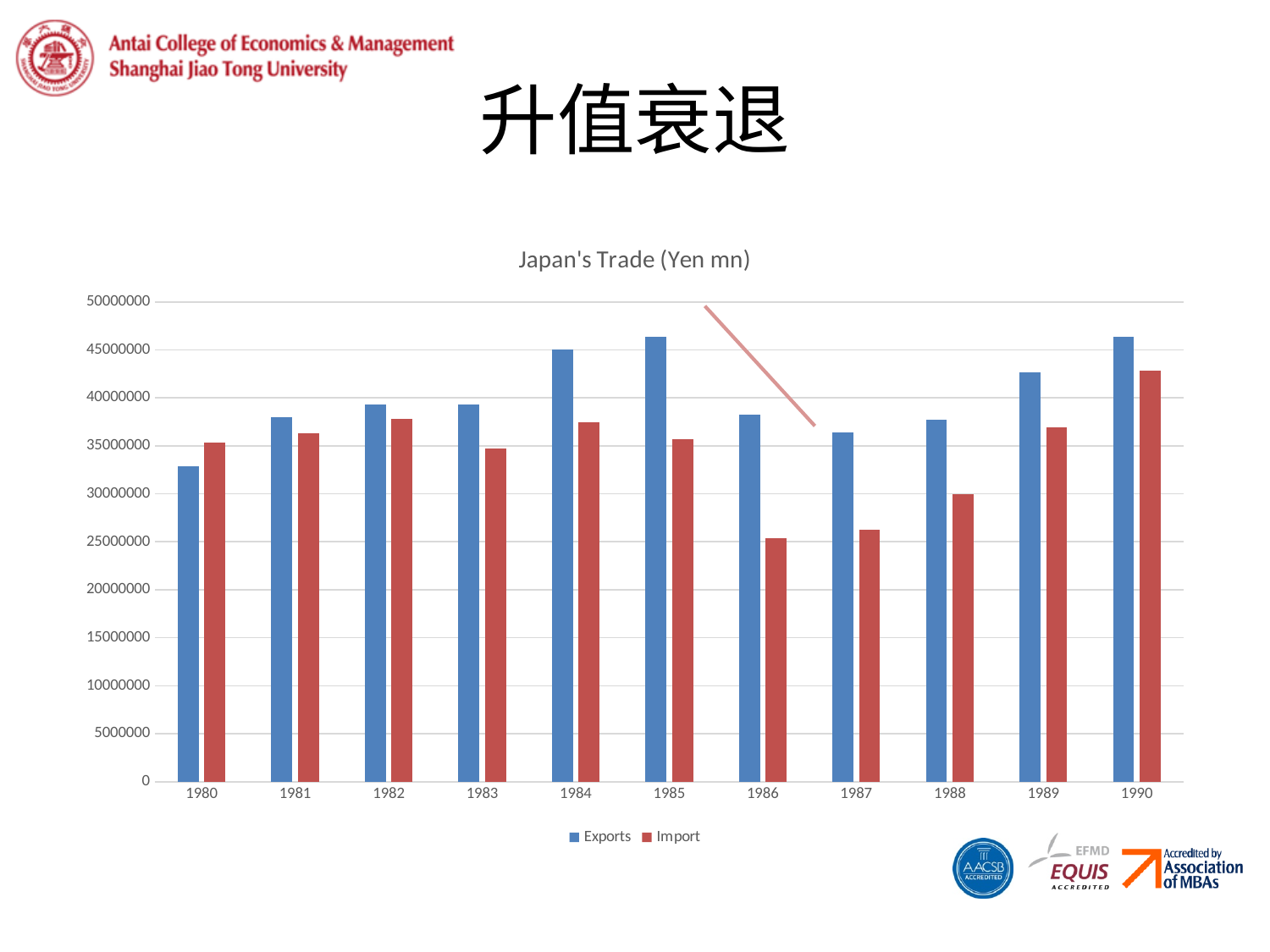
What is the title of the chart? Japan's Trade (Yen mn) What kind of chart is shown on the slide? bar chart Do Import values rise or fall from 1985 to 1986? fall How many series does the legend list? 2 Which year has the highest Import value? 1990 How many years are shown on the x axis? 11 Is the Exports value for 1984 greater or less than 40000000? greater Is the Exports value for 1980 greater or less than 35000000? less Is the Import value for 1986 greater or less than 30000000? less Which year has the lowest Exports value? 1980 In 1980, which is larger, Exports or Import? Import Which year has the lowest Import value? 1986